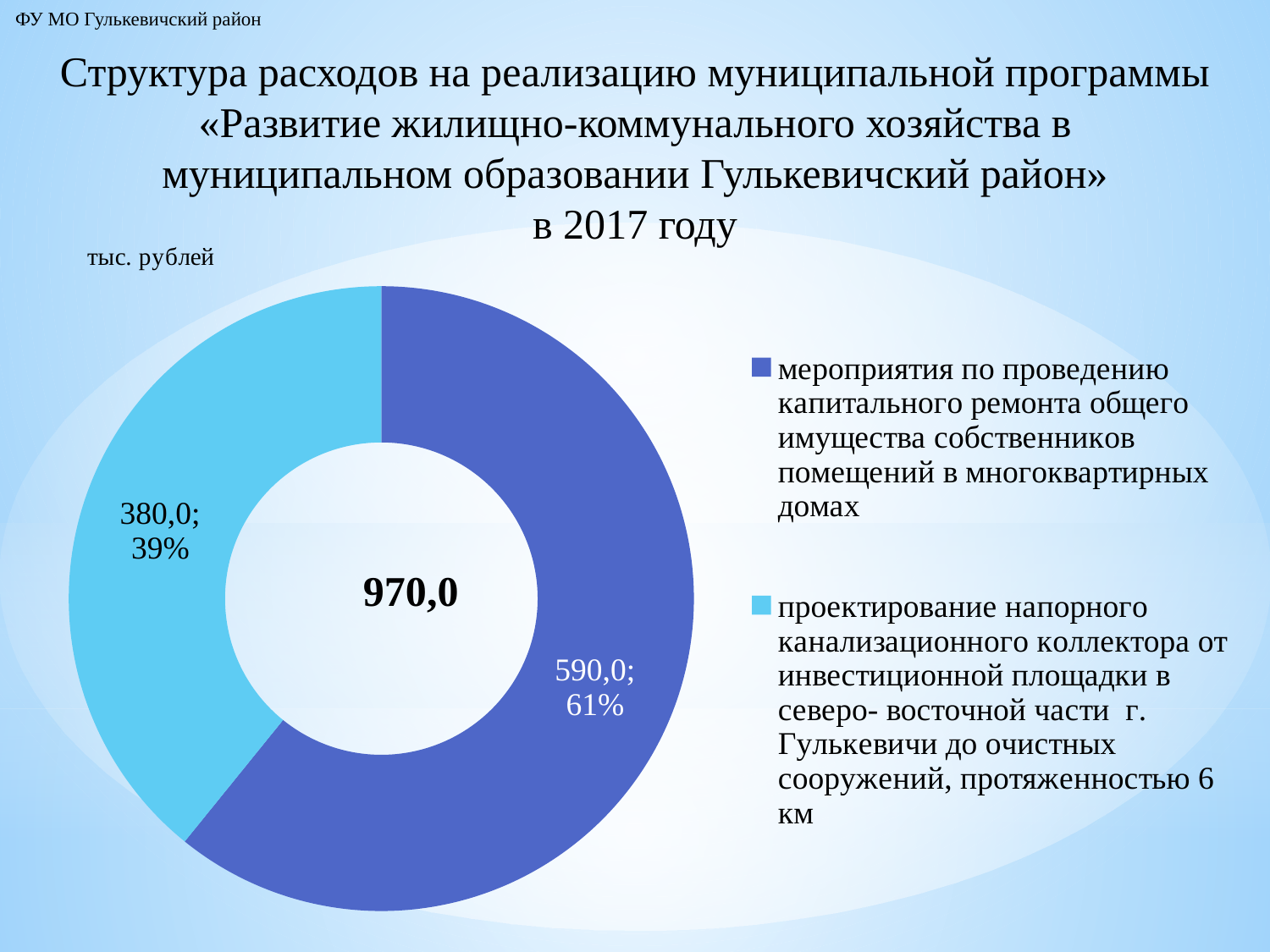
Which is larger: the value for capital repair of common property or the value for the sewer collector design? capital repair of common property (590,0) What share of the total does the design of the pressure sewer collector account for? 39% How many categories does the chart show? 2 Which category has the smallest value? проектирование напорного канализационного коллектора от инвестиционной площадки в северо-восточной части г. Гулькевичи до очистных сооружений, протяженностью 6 км What is the total shown in the centre of the chart? 970,0 What is the difference between the value for capital repair (590,0) and the value for the sewer collector design (380,0)? 210,0 What kind of chart is shown on the slide? Doughnut (pie) chart In what units are the values on the chart given? тыс. рублей What is the value for the design of the pressure sewer collector (проектирование напорного канализационного коллектора)? 380,0 Which category has the largest value? мероприятия по проведению капитального ремонта общего имущества собственников помещений в многоквартирных домах What share of the total does the capital repair of common property in apartment buildings account for? 61% What is the value for the capital repair of common property in apartment buildings (мероприятия по проведению капитального ремонта)? 590,0